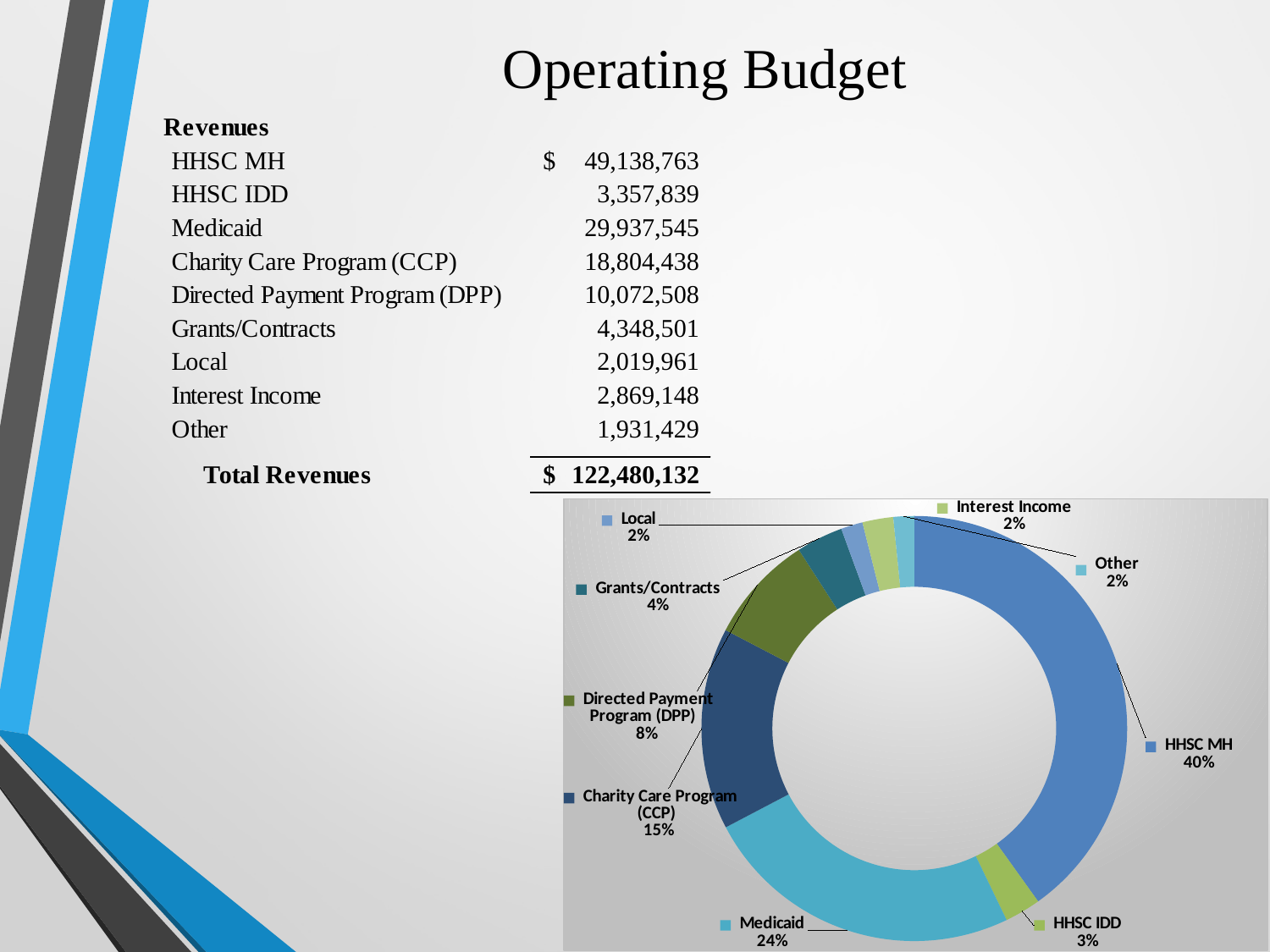
What percentage is shown for Directed Payment Program (DPP) in the doughnut chart? 8% What is the difference in percentage points between HHSC MH and Medicaid in the doughnut chart? 16 percentage points What percentage is shown for Charity Care Program (CCP) in the doughnut chart? 15% How many categories are shown in the doughnut chart? 9 Which has a larger share in the doughnut chart, Medicaid or Charity Care Program (CCP)? Medicaid What percentage is shown for Medicaid in the doughnut chart? 24% What share of the doughnut chart does HHSC MH represent? 40% Which category has the largest share in the doughnut chart? HHSC MH What percentage is shown for Grants/Contracts in the doughnut chart? 4% What kind of chart is shown on the slide? Doughnut (pie) chart Which three categories in the doughnut chart each show 2%? Local, Interest Income, Other What percentage is shown for HHSC IDD in the doughnut chart? 3%